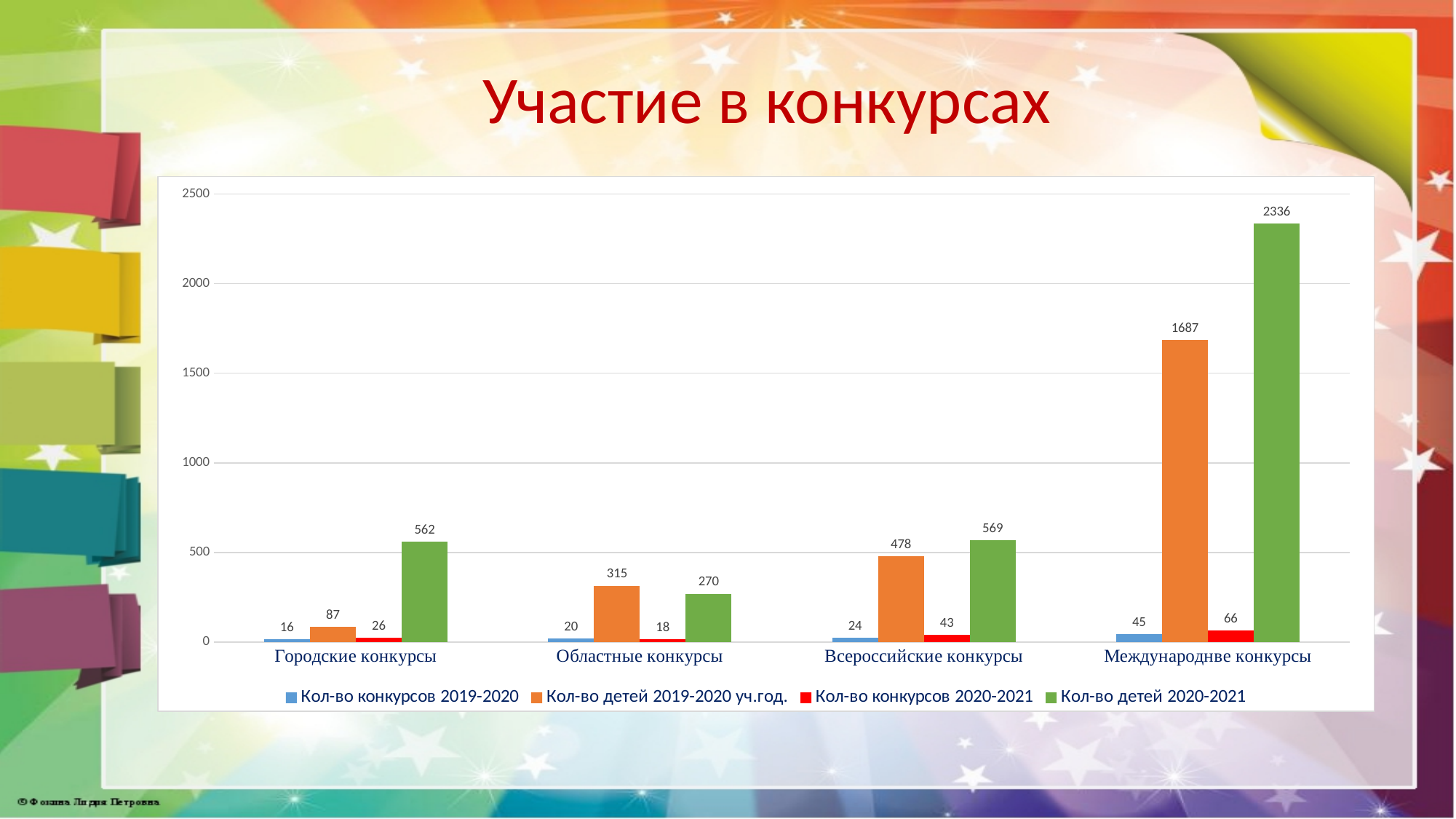
What is the value of Кол-во детей 2019-2020 уч.год. for Областные конкурсы? 315 What is the value of Кол-во конкурсов 2020-2021 for Всероссийские конкурсы? 43 What is the value of Кол-во детей 2020-2021 for Международнве конкурсы? 2336 What type of chart is shown on the slide? bar chart What is the title of the chart on the slide? Участие в конкурсах Which category has the lowest value for Кол-во конкурсов 2019-2020? Городские конкурсы Does the value of Кол-во детей 2019-2020 уч.год. for Всероссийские конкурсы rise or fall compared with Областные конкурсы? rise How many categories are shown on the x axis? 4 Which category has the highest value for Кол-во детей 2020-2021? Международнве конкурсы How many series does the legend list? 4 For Областные конкурсы, which is larger: Кол-во детей 2019-2020 уч.год. or Кол-во детей 2020-2021? Кол-во детей 2019-2020 уч.год. What is the difference between Кол-во детей 2020-2021 and Кол-во детей 2019-2020 уч.год. for Международнве конкурсы? 649